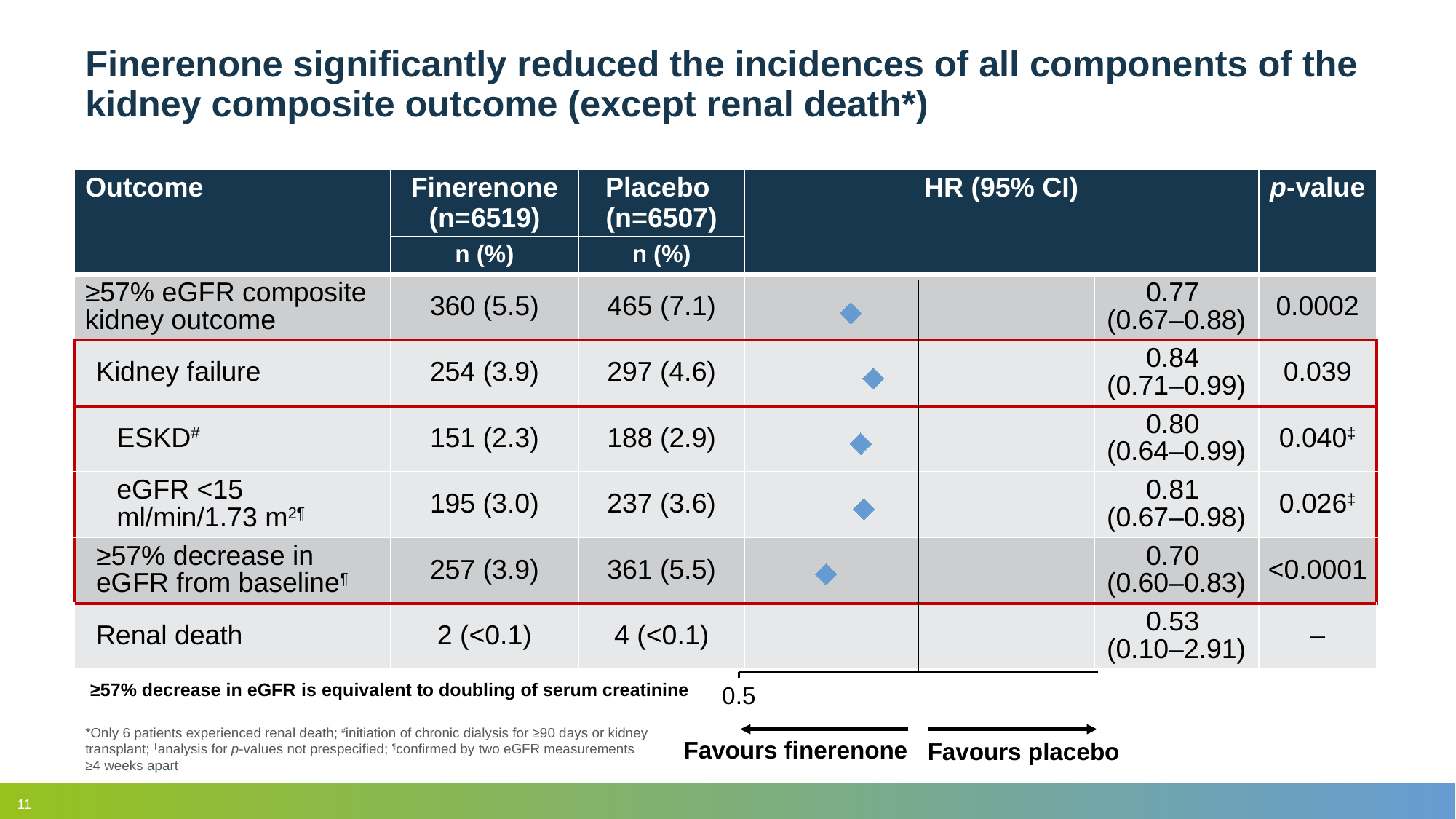
Among the outcomes with a diamond marker plotted, which has the lowest hazard ratio? ≥57% decrease in eGFR from baseline What is the only numeric tick label shown on the forest plot axis? 0.5 Which has the larger hazard ratio, Kidney failure or ≥57% decrease in eGFR from baseline? Kidney failure How many diamond markers are plotted in the HR (95% CI) forest plot? 5 What is the difference between the hazard ratio for Kidney failure and the hazard ratio for ≥57% decrease in eGFR from baseline? 0.14 What is the p-value for the ≥57% eGFR composite kidney outcome? 0.0002 What is the 95% CI for the ≥57% eGFR composite kidney outcome? (0.67–0.88) What is the HR (95% CI) shown for Kidney failure? 0.84 (0.71–0.99) Among the outcomes with a diamond marker plotted, which has the highest hazard ratio? Kidney failure What label is shown under the left-pointing arrow beneath the forest plot? Favours finerenone What kind of chart is shown in the HR (95% CI) column? Forest plot What is the hazard ratio for ≥57% decrease in eGFR from baseline? 0.70